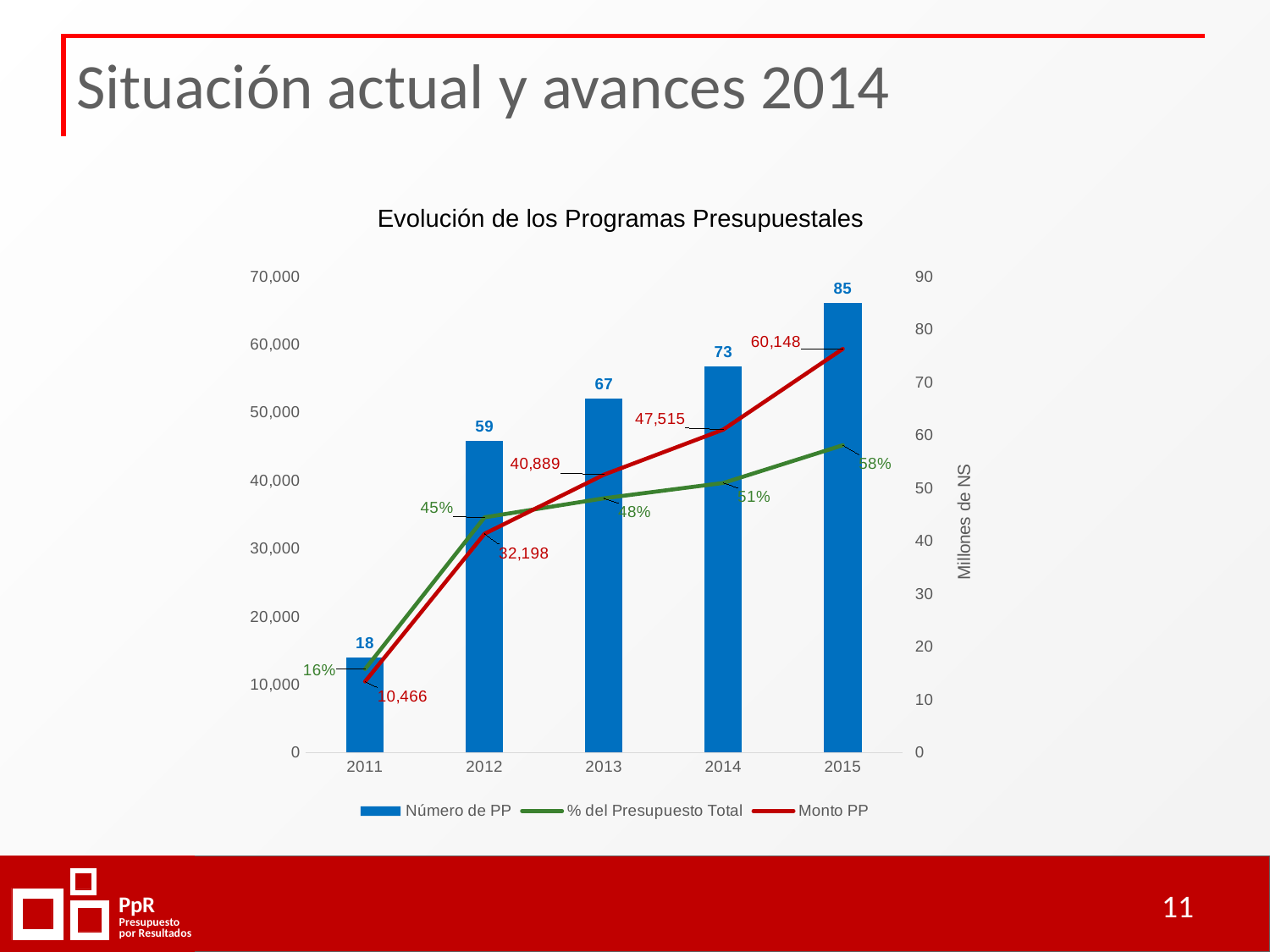
Which year has the lowest Número de PP? 2011 How many series does the legend list? 3 What is the % del Presupuesto Total for 2012? 45% What is the title of the chart? Evolución de los Programas Presupuestales What is the difference in Número de PP between 2015 and 2014? 12 What is the difference in Monto PP between 2014 and 2013? 6,626 Which is larger, the Número de PP in 2012 or in 2013? 2013 What is the Monto PP value for 2013? 40,889 Which year has the highest Monto PP? 2015 How many years are shown on the x axis? 5 Does the % del Presupuesto Total rise or fall from 2011 to 2015? rise What is the value of Número de PP for 2015? 85